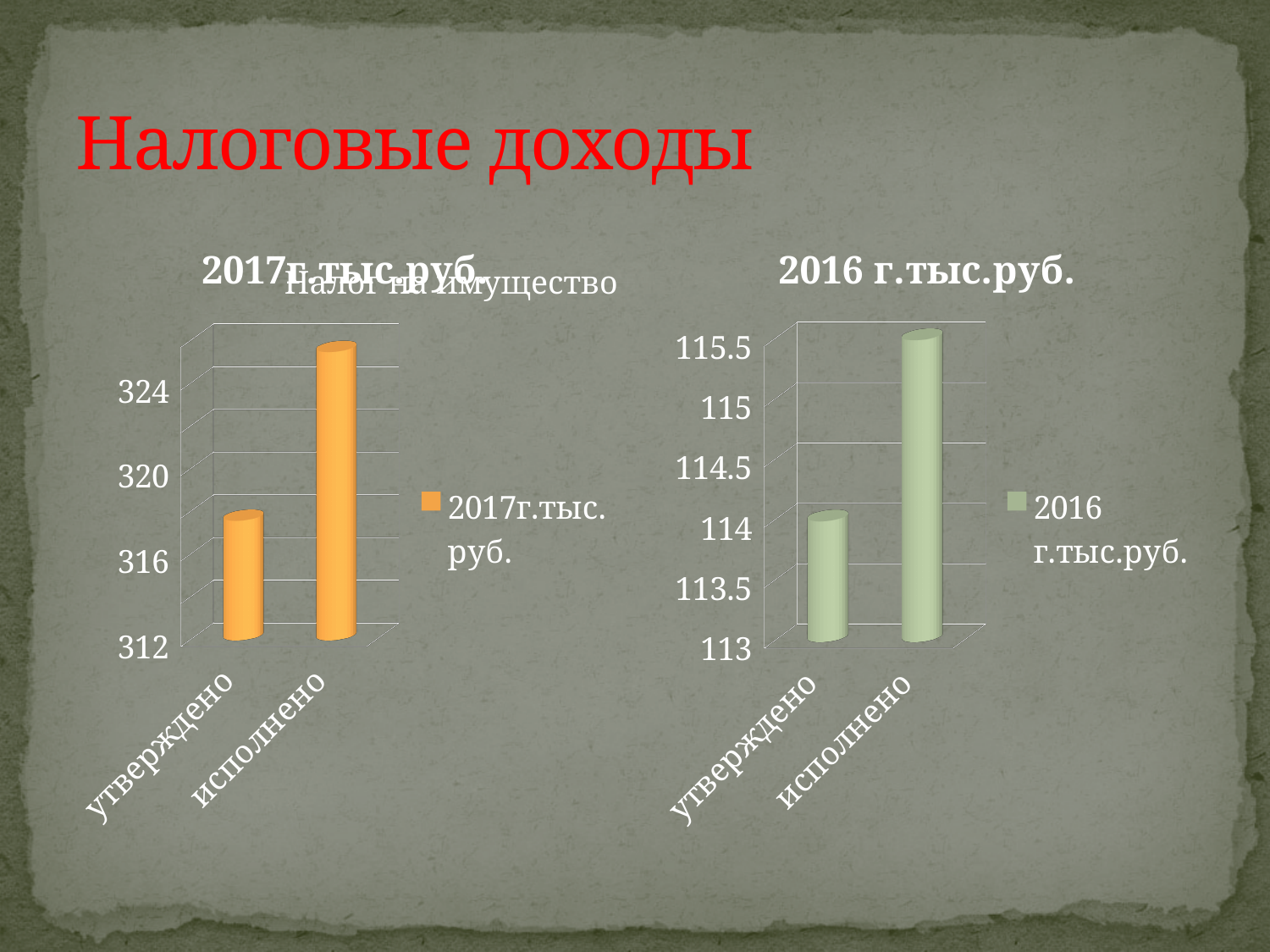
What is the title of the right chart? 2016 г.тыс.руб. In the left chart (2017г.тыс.руб.), which category has the lower value? утверждено How many series does the legend of the right chart (2016 г.тыс.руб.) list? 1 In the left chart (2017г.тыс.руб.), which category has the higher value? исполнено What is the legend entry of the left chart? 2017г.тыс.руб. In the left chart (2017г.тыс.руб.), is the value for утверждено greater or less than 320? less How many categories are shown in the left chart (2017г.тыс.руб.)? 2 In the right chart (2016 г.тыс.руб.), is the value for исполнено greater or less than 115? greater In the right chart (2016 г.тыс.руб.), which category has the higher value? исполнено In the right chart (2016 г.тыс.руб.), is the value for утверждено greater or less than 114.5? less What type of chart is the left chart titled 2017г.тыс.руб.? bar chart